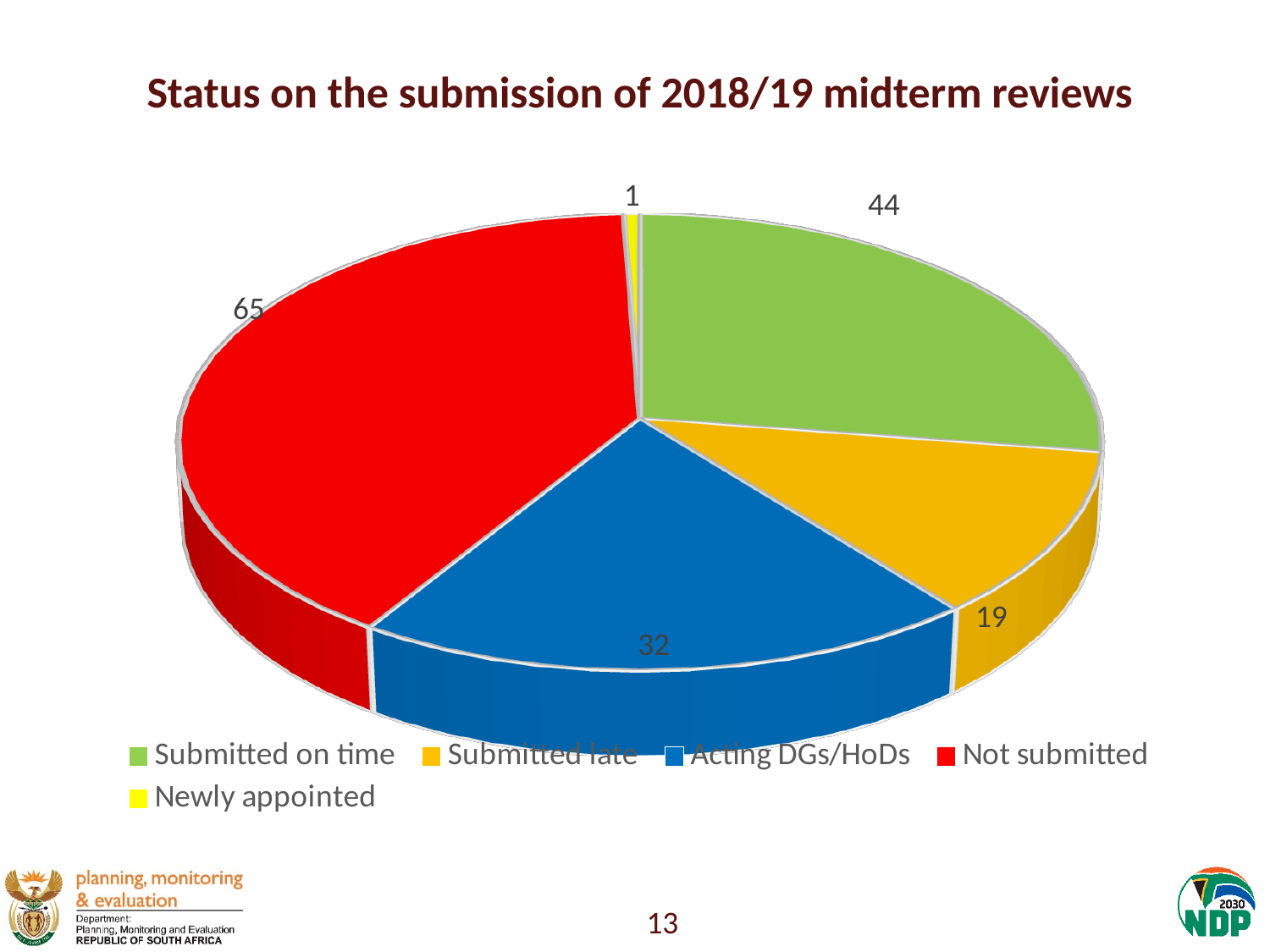
What is the value for Acting DGs/HoDs? 32 What is the value for Submitted on time? 44 Which is larger, Submitted late or Acting DGs/HoDs? Acting DGs/HoDs What is the value for Not submitted? 65 What is the total of all slices in the pie chart? 161 How many categories does the pie chart show? 5 What is the difference between Not submitted and Submitted on time? 21 What kind of chart is shown on the slide? Pie chart Which category has the largest slice? Not submitted What is the title of the chart? Status on the submission of 2018/19 midterm reviews Which category has the smallest slice? Newly appointed What is the value for Newly appointed? 1